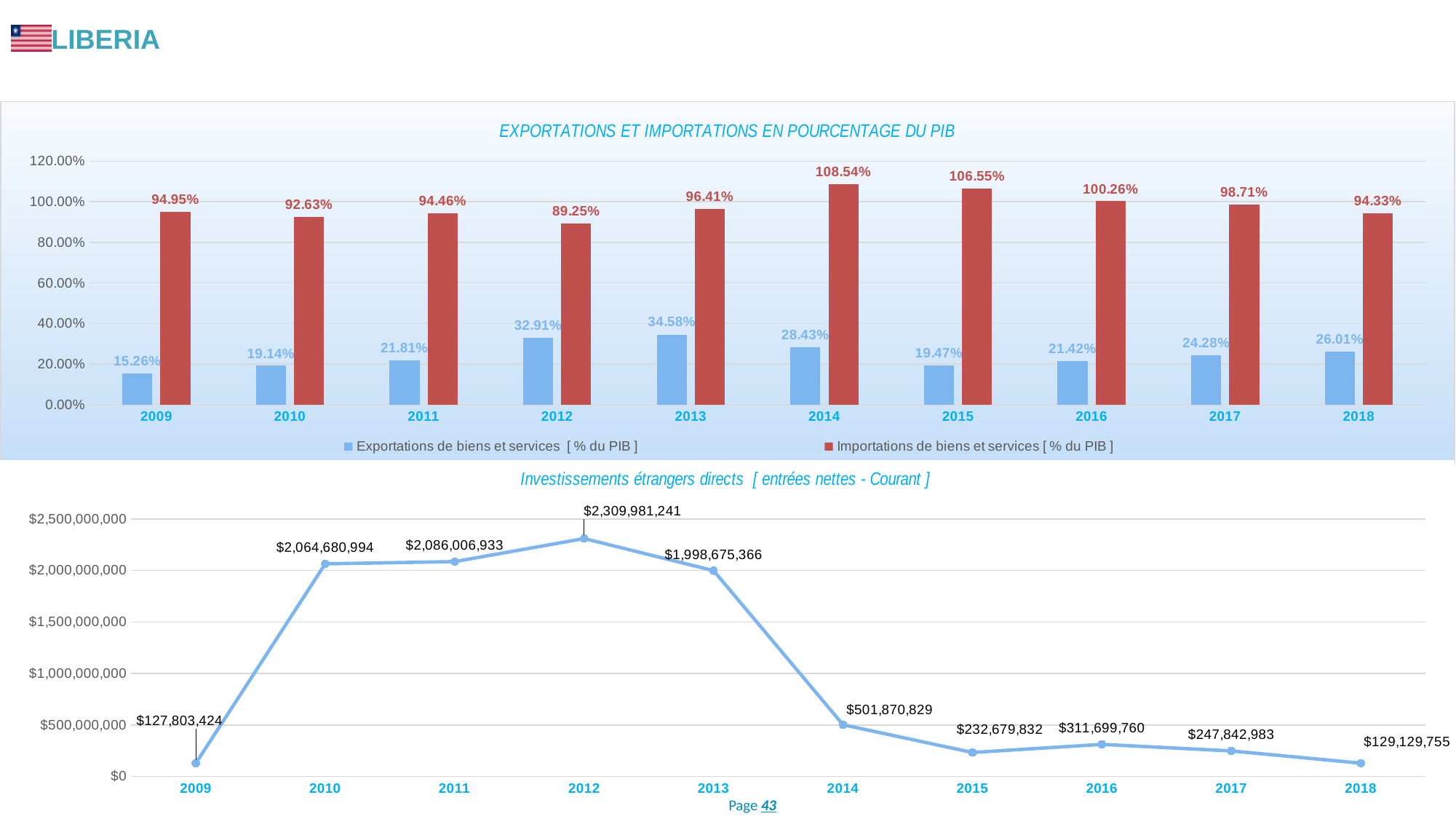
In the chart 'Investissements étrangers directs', which year has the lowest value? 2009 In the chart 'EXPORTATIONS ET IMPORTATIONS EN POURCENTAGE DU PIB', which year has the highest value for Importations de biens et services? 2014 In the chart 'EXPORTATIONS ET IMPORTATIONS EN POURCENTAGE DU PIB', what colour are the Importations bars? Red In the chart 'EXPORTATIONS ET IMPORTATIONS EN POURCENTAGE DU PIB', which year has the lowest value for Exportations de biens et services? 2009 In the chart 'Investissements étrangers directs', what kind of chart is it? Line chart In the chart 'EXPORTATIONS ET IMPORTATIONS EN POURCENTAGE DU PIB', how many series does the legend list? 2 In the chart 'Investissements étrangers directs', what is the value for 2012? $2,309,981,241 In the chart 'Investissements étrangers directs', how many years are plotted? 10 In the chart 'EXPORTATIONS ET IMPORTATIONS EN POURCENTAGE DU PIB', what is the value of Exportations de biens et services for 2013? 34.58% In the chart 'EXPORTATIONS ET IMPORTATIONS EN POURCENTAGE DU PIB', what is the value of Importations de biens et services for 2014? 108.54% In the chart 'Investissements étrangers directs', is the value for 2016 greater or less than $500,000,000? less In the chart 'EXPORTATIONS ET IMPORTATIONS EN POURCENTAGE DU PIB', what is the difference between Importations and Exportations in 2012? 56.34%